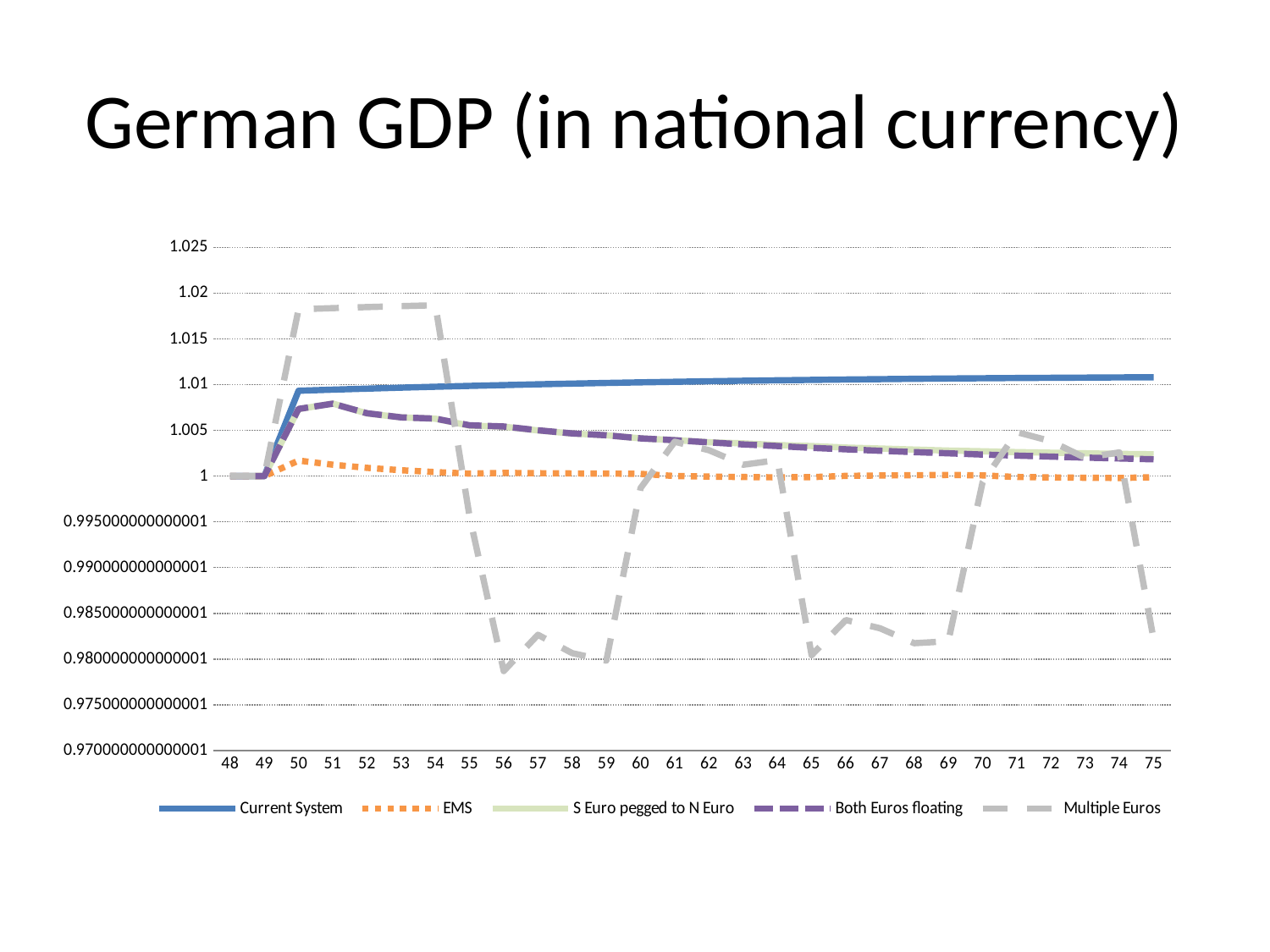
Does the Current System series rise or fall from 50 to 75? rise How many points are plotted along the x axis (from 48 to 75)? 28 Which series has the lowest value at 56? Multiple Euros Is the value for Current System at 75 greater or less than 1.005? greater Is the value for Multiple Euros at 52 greater or less than 1.015? greater Is the value for Multiple Euros at 57 greater or less than 0.985? less At 51, which is larger: Multiple Euros or Current System? Multiple Euros What is the title of the chart? German GDP (in national currency) Which series has the highest value at 75? Current System How many series does the legend list? 5 What kind of chart is shown on the slide? line chart Which series is drawn as a solid blue line? Current System